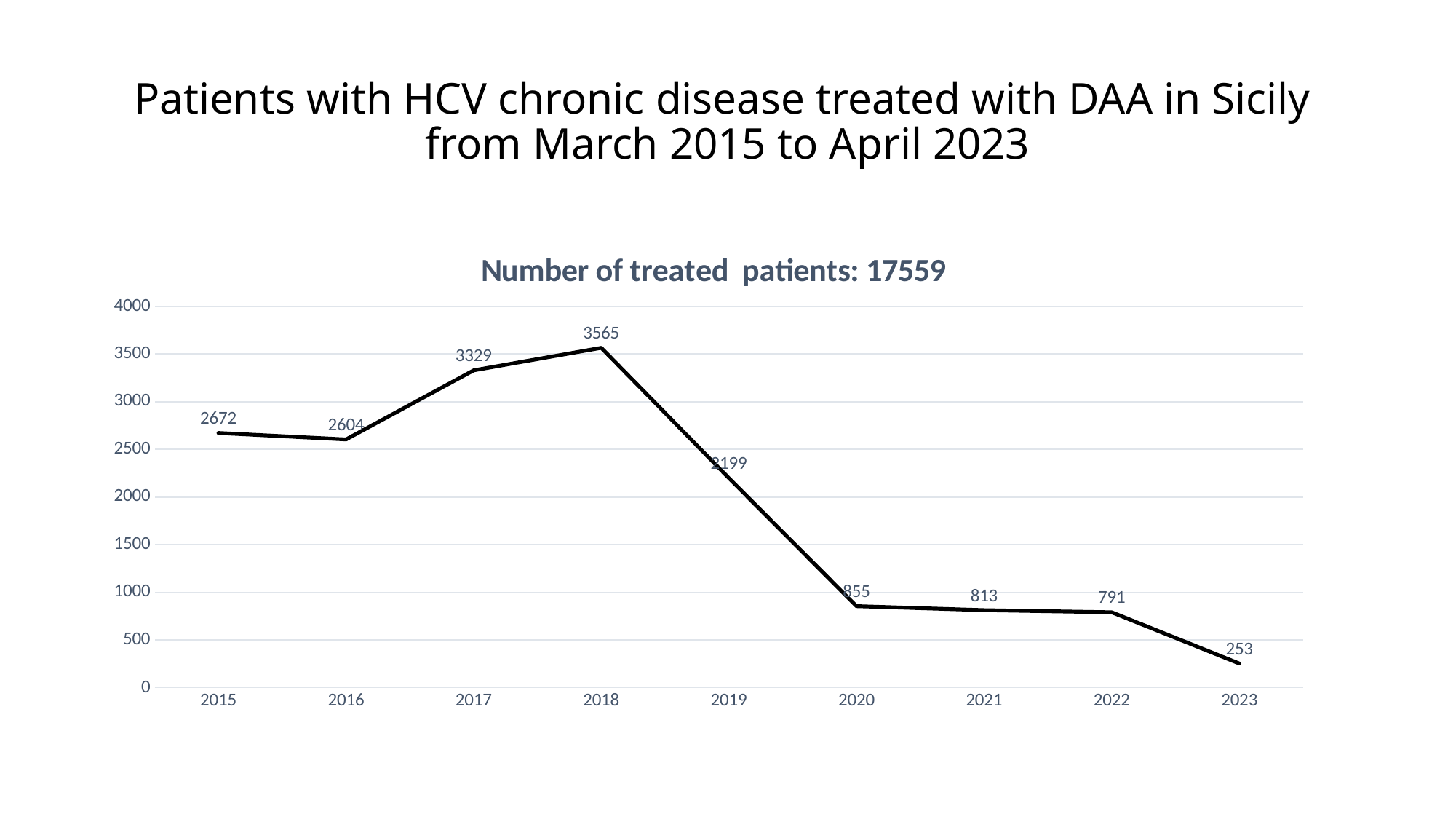
Which year has the lowest number of treated patients? 2023 What type of chart is shown on the slide? line chart Which year has the highest number of treated patients? 2018 How many treated patients are shown for 2018? 3565 Which is larger, the value for 2017 or the value for 2016? 2017 What is the difference between the values for 2021 and 2022? 22 What is the difference between the values for 2018 and 2019? 1366 Do the values rise or fall from 2018 to 2023? fall What is the value for 2015? 2672 What is the chart's title? Number of treated patients: 17559 How many years are plotted on the x axis? 9 What is the value for 2023? 253